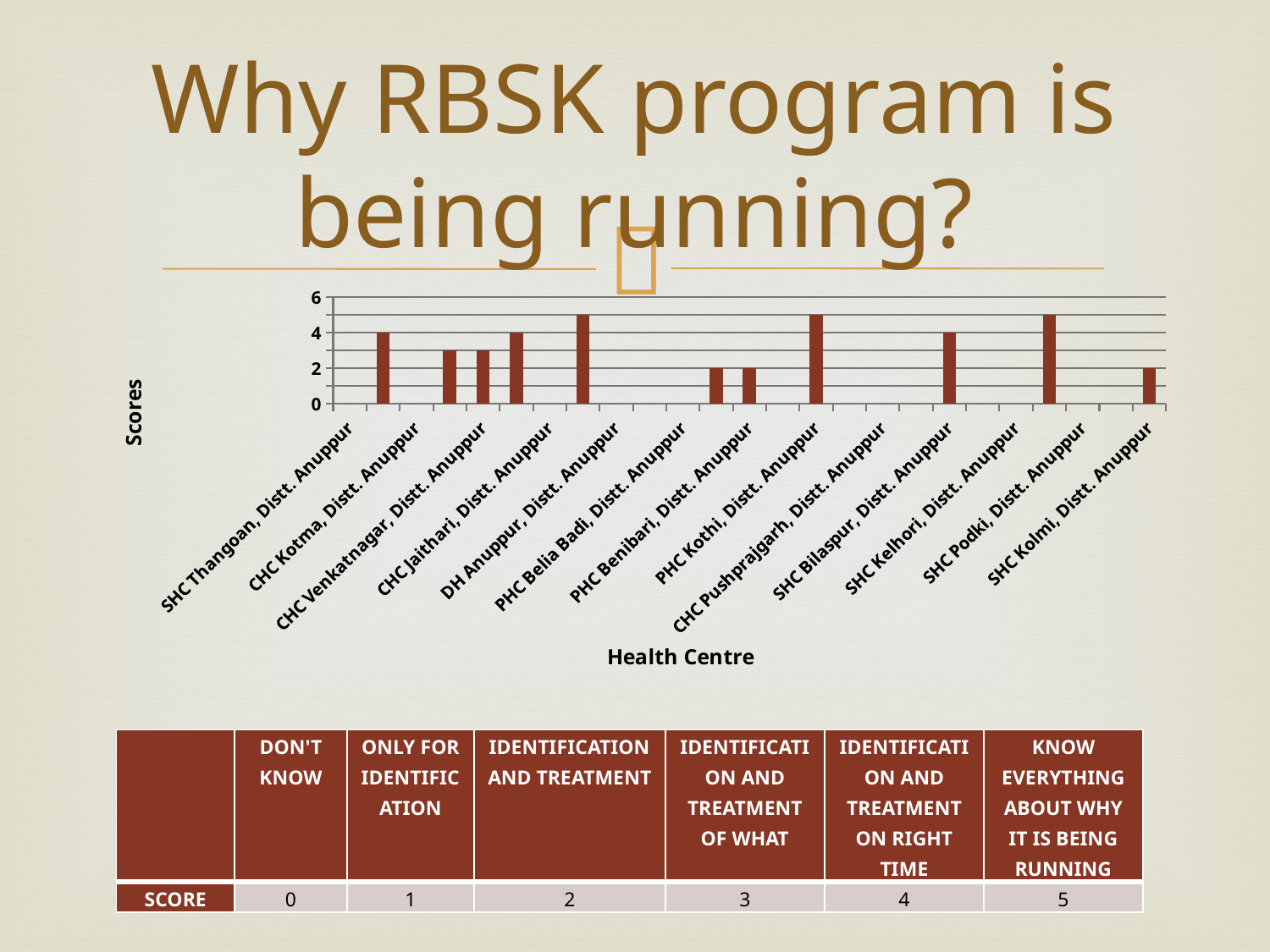
According to the table below the chart, what score corresponds to 'Don't know'? 0 What is the label of the horizontal axis of the chart? Health Centre What is the title of the slide containing the chart? Why RBSK program is being running? Is the shortest non-zero bar in the chart greater or less than 4? less What kind of chart is shown on the slide? bar chart What is the lowest non-zero score shown by a bar in the chart? 2 Is the tallest bar in the chart greater or less than 4? greater Does any bar in the chart reach the value 6? No